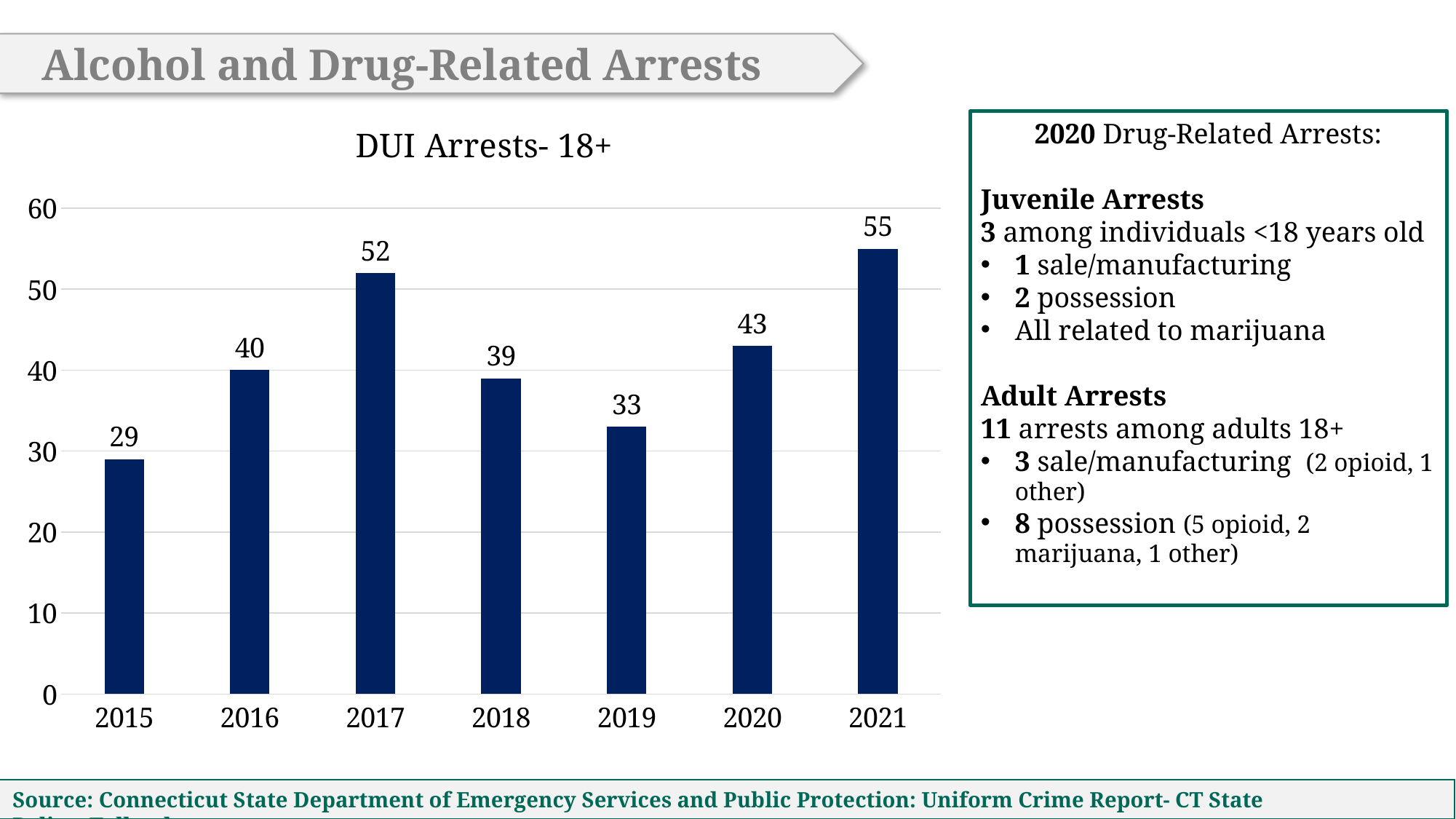
What is the title of the chart on the slide? DUI Arrests- 18+ What is the difference between the DUI arrests in 2017 and 2018? 13 Which year has the highest number of DUI arrests in the chart? 2021 What is the value for 2015 in the DUI Arrests- 18+ chart? 29 What is the difference between the DUI arrests in 2021 and 2015? 26 Which year has more DUI arrests, 2016 or 2020? 2020 What is the value for 2017 in the DUI Arrests- 18+ chart? 52 How many years are shown on the x axis of the DUI Arrests- 18+ chart? 7 What is the value for 2019 in the DUI Arrests- 18+ chart? 33 Is the value for 2018 greater or less than 40? less Which year has the lowest number of DUI arrests in the chart? 2015 What kind of chart is used to show DUI Arrests- 18+? bar chart